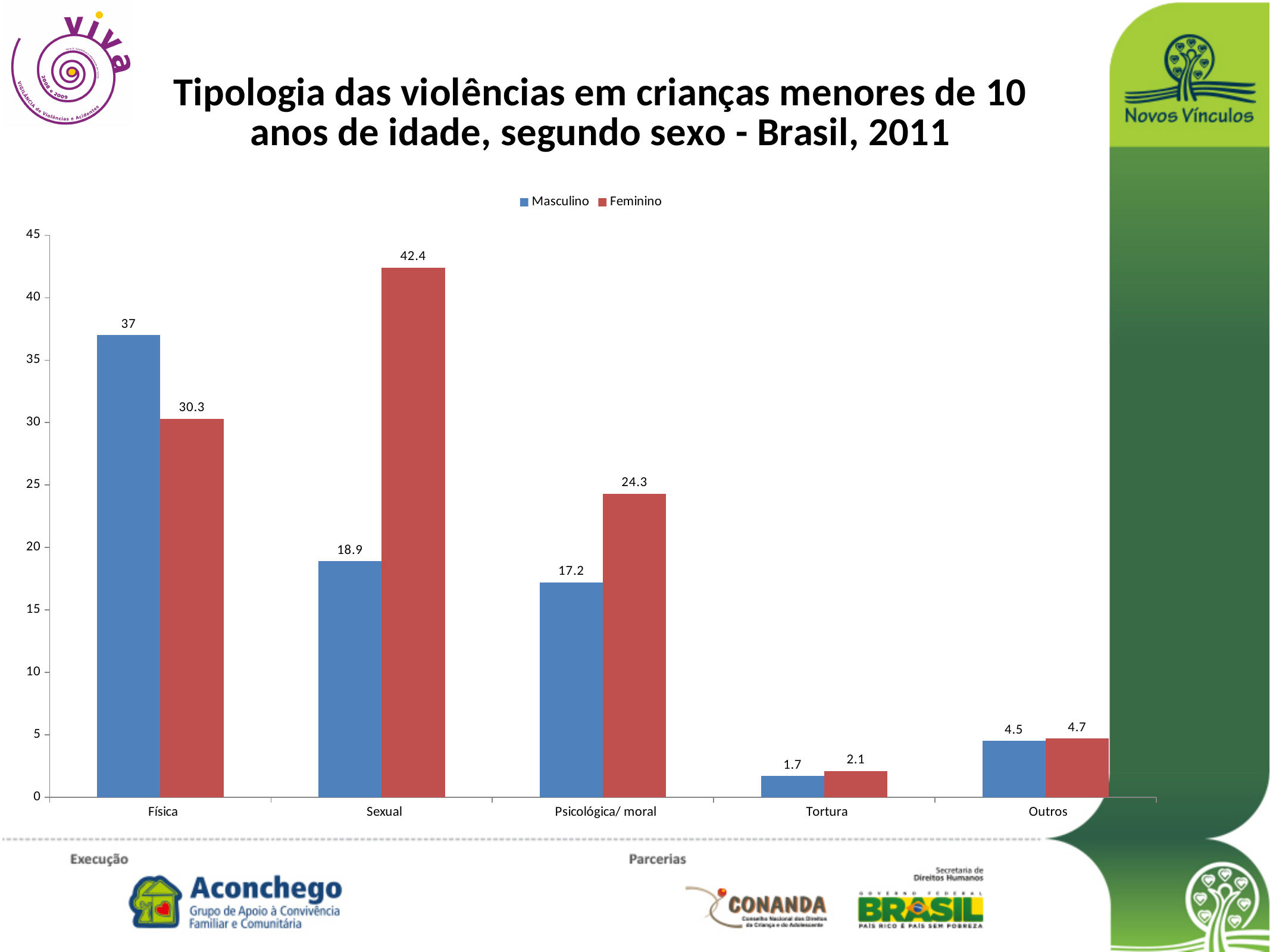
What is the Feminino value for Psicológica/ moral? 24.3 Which category has the highest Feminino value? Sexual Which is larger for Física, the Masculino or the Feminino value? Masculino How many categories are shown on the x axis? 5 Which colour represents the Feminino series? Red What is the Masculino value for Física? 37 What is the difference between the Feminino and Masculino values for Sexual? 23.5 What is the Masculino value for Tortura? 1.7 What kind of chart is shown on the slide? Bar chart How many series does the legend list? 2 What is the Feminino value for Sexual? 42.4 Which category has the lowest Masculino value? Tortura